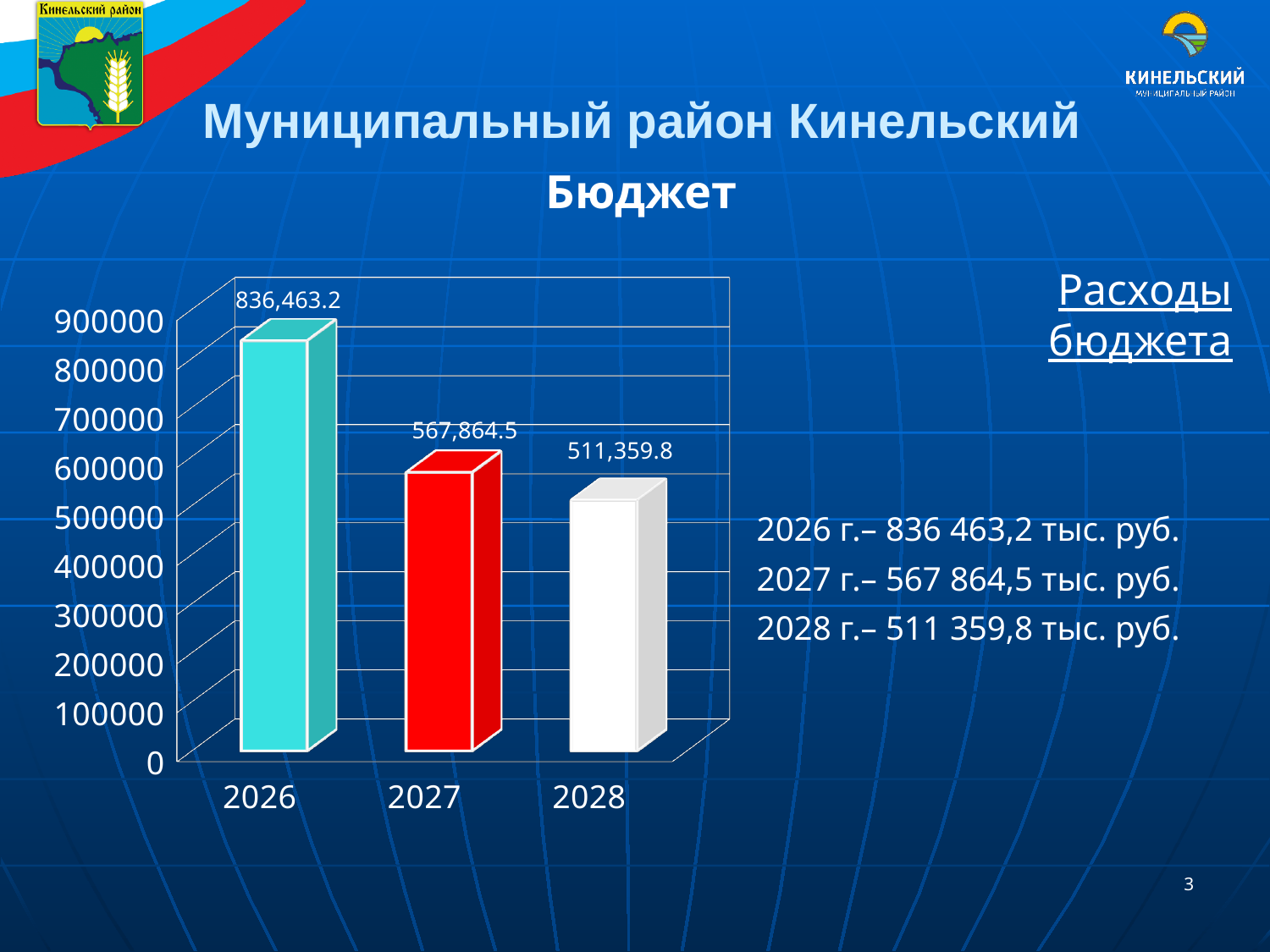
What is the value shown for 2026? 836,463.2 How many years are shown on the x axis? 3 What kind of chart is shown on the slide? bar chart Which year has the lowest value? 2028 What is the value shown for 2027? 567,864.5 What is the difference between the values for 2027 and 2028? 56,504.7 What is the difference between the values for 2026 and 2027? 268,598.7 Do the values rise or fall from 2026 to 2028? fall Which year has the highest value? 2026 Which is larger, the value for 2027 or the value for 2028? 2027 Is the value for 2026 greater or less than 800000? greater What is the value shown for 2028? 511,359.8